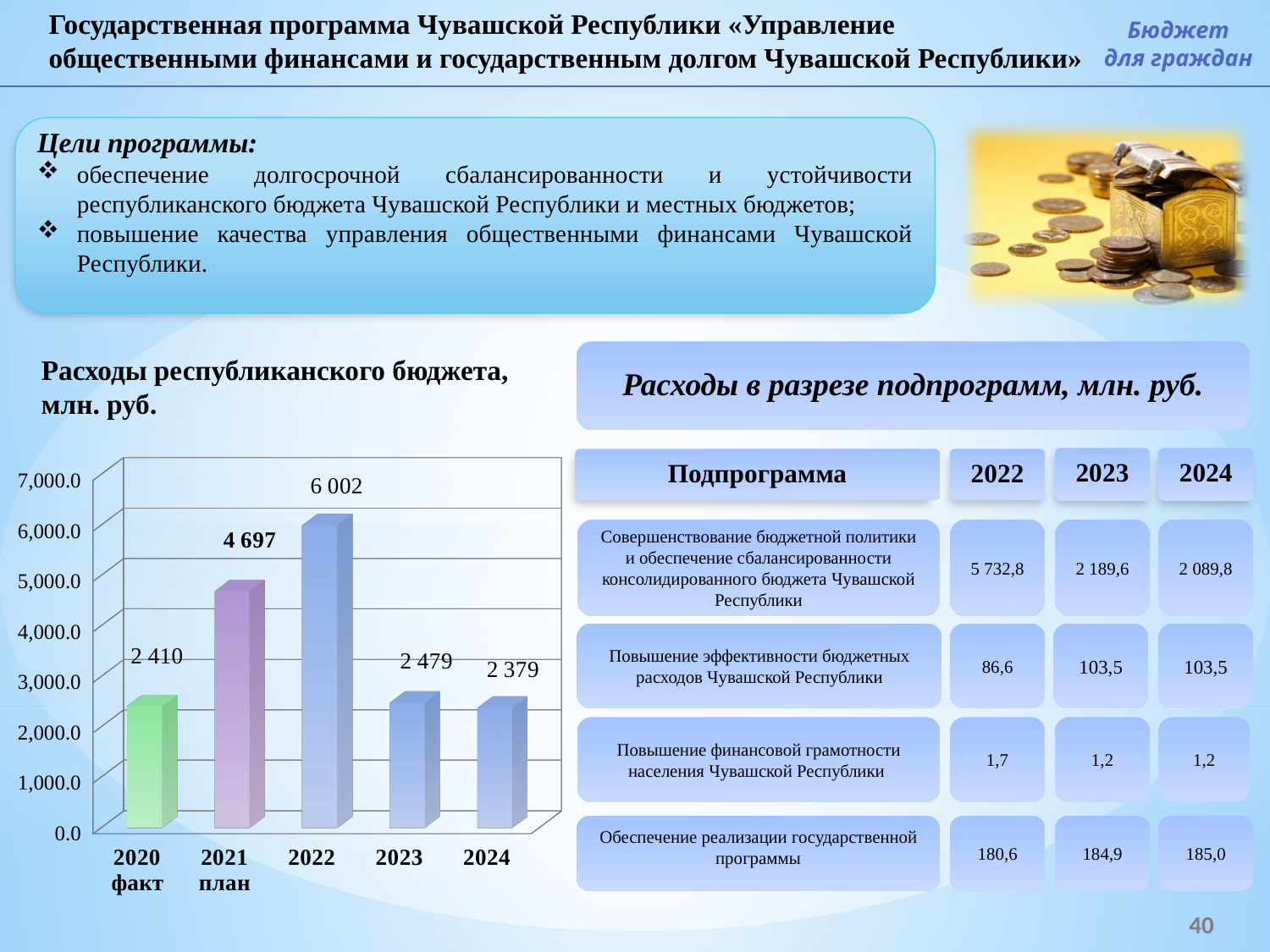
What is the difference between the values for 2023 and 2024 in the chart 'Расходы республиканского бюджета, млн. руб.'? 100 What is the value for 2021 план in the chart 'Расходы республиканского бюджета, млн. руб.'? 4 697 In the chart 'Расходы республиканского бюджета, млн. руб.', which is larger: the value for 2021 план or the value for 2023? 2021 план What is the value for 2024 in the chart 'Расходы республиканского бюджета, млн. руб.'? 2 379 Which year has the highest value in the chart 'Расходы республиканского бюджета, млн. руб.'? 2022 Which year has the lowest value in the chart 'Расходы республиканского бюджета, млн. руб.'? 2024 What kind of chart is 'Расходы республиканского бюджета, млн. руб.'? bar chart What is the difference between the values for 2022 and 2021 план in the chart 'Расходы республиканского бюджета, млн. руб.'? 1 305 Is the value for 2022 in the chart 'Расходы республиканского бюджета, млн. руб.' greater or less than 5,000.0? greater How many bars are shown in the chart 'Расходы республиканского бюджета, млн. руб.'? 5 What is the value for 2020 факт in the chart 'Расходы республиканского бюджета, млн. руб.'? 2 410 What is the value for 2022 in the chart 'Расходы республиканского бюджета, млн. руб.'? 6 002